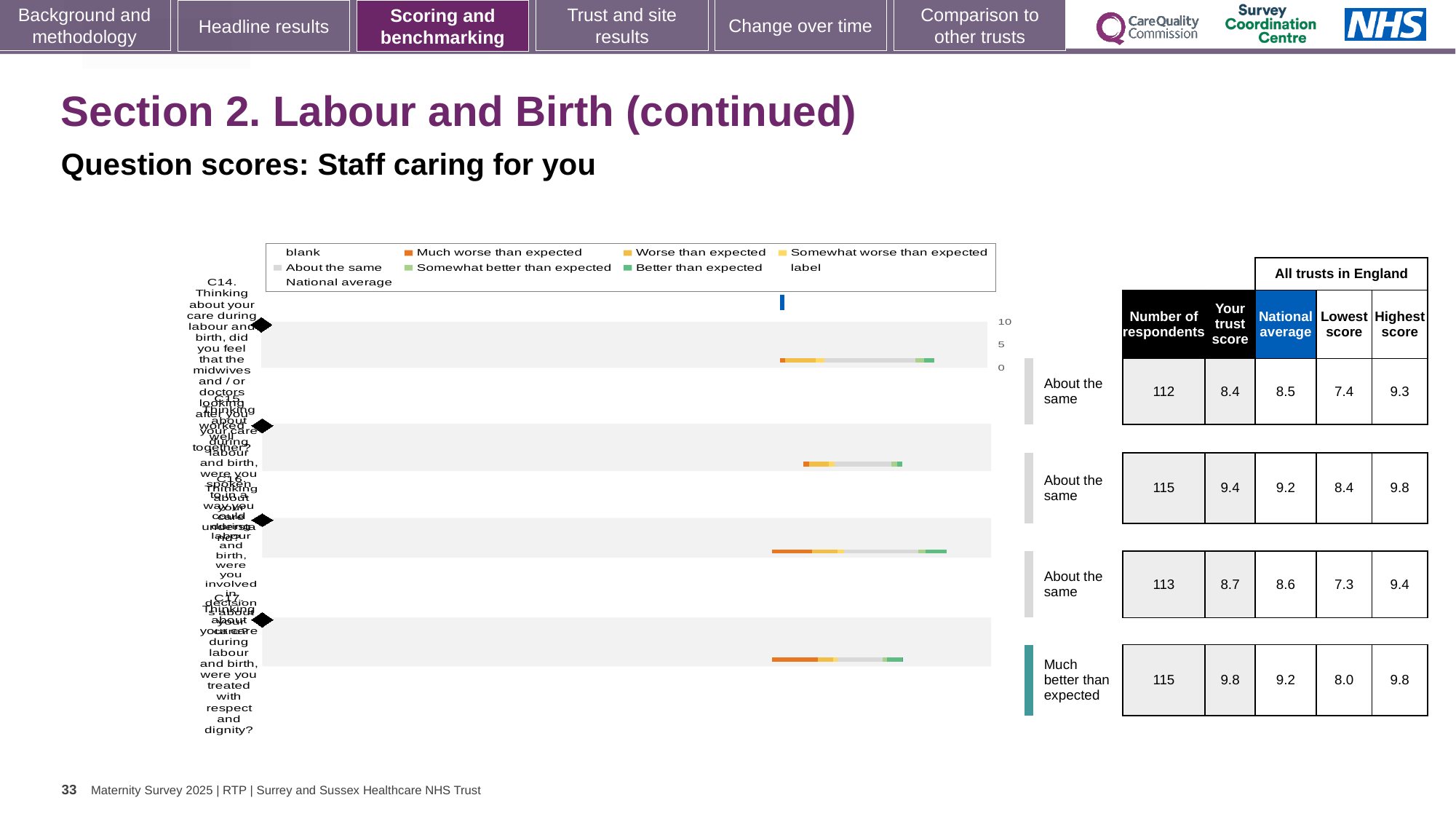
How many questions (bars) are plotted in the chart? 4 What is the benchmark category shown for question C17 (treated with respect and dignity)? Much better than expected For question C17, which is larger: the trust score or the national average? the trust score What is the difference between the trust score and the national average for question C17? 0.6 What is the trust score for the last question, C17 (were you treated with respect and dignity)? 9.8 What is the national average for question C14? 8.5 What is the lowest score among all trusts in England for question C14? 7.4 How many respondents answered question C14? 112 What is the trust score for question C14 (did the midwives and/or doctors looking after you work well together)? 8.4 What kind of chart is shown on the slide? bar chart Which question has the lowest trust score? C14 (midwives and/or doctors worked well together) Which question has the highest trust score? C17 (treated with respect and dignity)